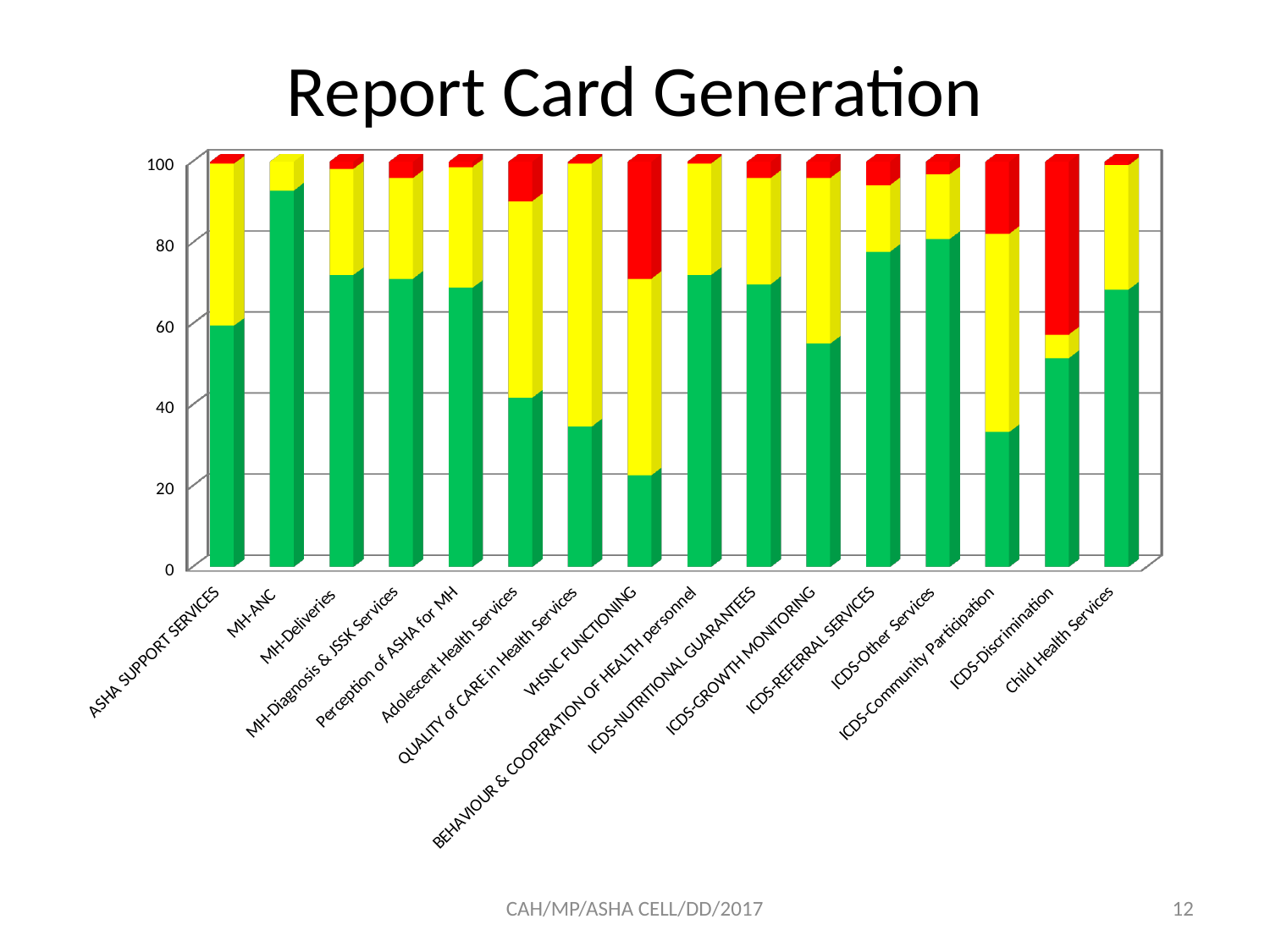
What is the total height of the stacked bar for MH-ANC? 100 What is the title of the chart on the slide? Report Card Generation Is the green segment for MH-ANC greater or less than 80? greater Which category has the tallest green segment? MH-ANC Which category has the shortest green segment? VHSNC FUNCTIONING What kind of chart is shown on the slide? Stacked bar chart Is the green segment for Adolescent Health Services greater or less than 60? less Which has the larger red segment, ICDS-Discrimination or ICDS-Community Participation? ICDS-Discrimination Is the green segment for ICDS-Other Services greater or less than 60? greater Which has the larger green segment, MH-ANC or VHSNC FUNCTIONING? MH-ANC How many categories are plotted along the x axis of the chart? 16